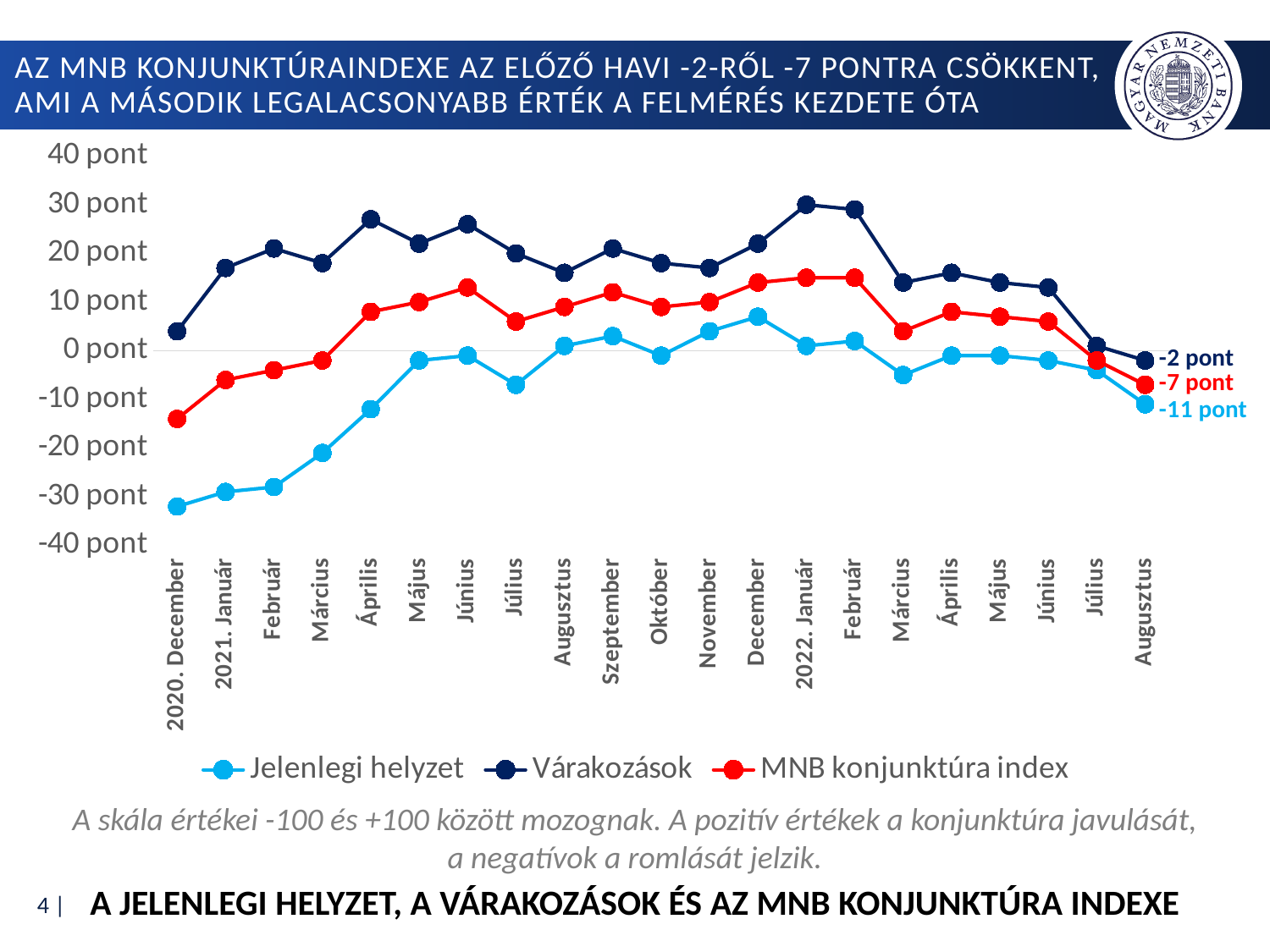
In which month is Jelenlegi helyzet at its lowest? 2020. December What is the value of Várakozások in Augusztus (2022)? -2 pont What is the value of the MNB konjunktúra index in Augusztus (2022)? -7 pont Does Jelenlegi helyzet rise or fall from 2020. December to Június 2021? rise In Augusztus (2022), what is the difference between Várakozások and Jelenlegi helyzet? 9 pont What kind of chart is shown on the slide? line chart What is the value of Jelenlegi helyzet in Augusztus (2022)? -11 pont How many months are plotted on the x axis? 21 How many series does the legend list? 3 Is the value for Várakozások in 2022. Január greater or less than 20 pont? greater In Augusztus (2022), which is higher: Várakozások or the MNB konjunktúra index? Várakozások Is the value for Jelenlegi helyzet in 2020. December greater or less than -20 pont? less